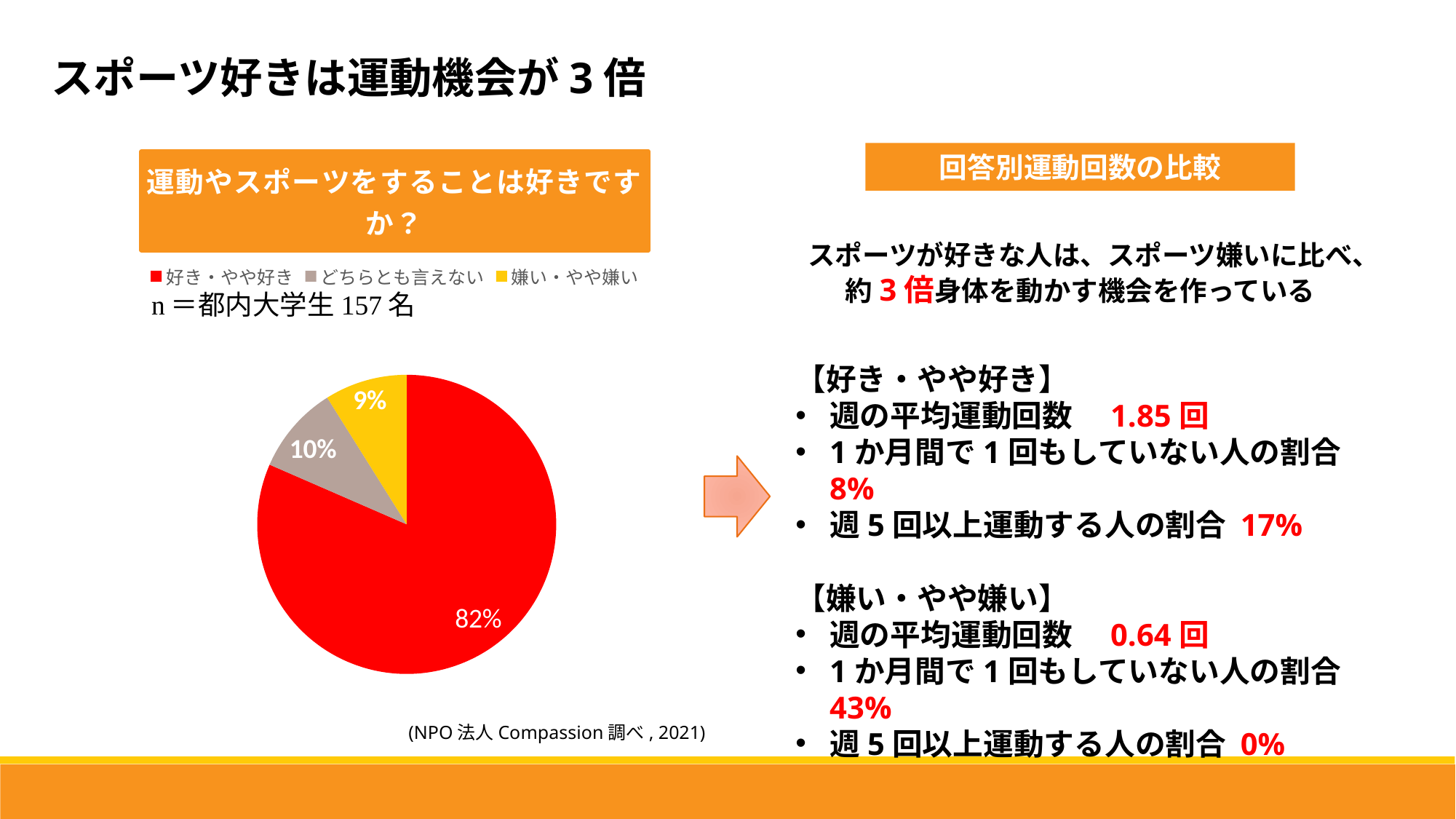
How many entries does the pie chart's legend list? 3 What is the difference between the 好き・やや好き share and the どちらとも言えない share? 72% What share of the pie is 好き・やや好き? 82% What share of the pie is 嫌い・やや嫌い? 9% What is the title of the pie chart? 運動やスポーツをすることは好きですか？ What colour is the 嫌い・やや嫌い slice in the pie chart? yellow What kind of chart is shown on the slide? pie chart Which is larger, the share for どちらとも言えない or the share for 嫌い・やや嫌い? どちらとも言えない Which category has the largest slice of the pie? 好き・やや好き Which category has the smallest slice of the pie? 嫌い・やや嫌い What share of the pie is どちらとも言えない? 10% How many slices does the pie chart have? 3